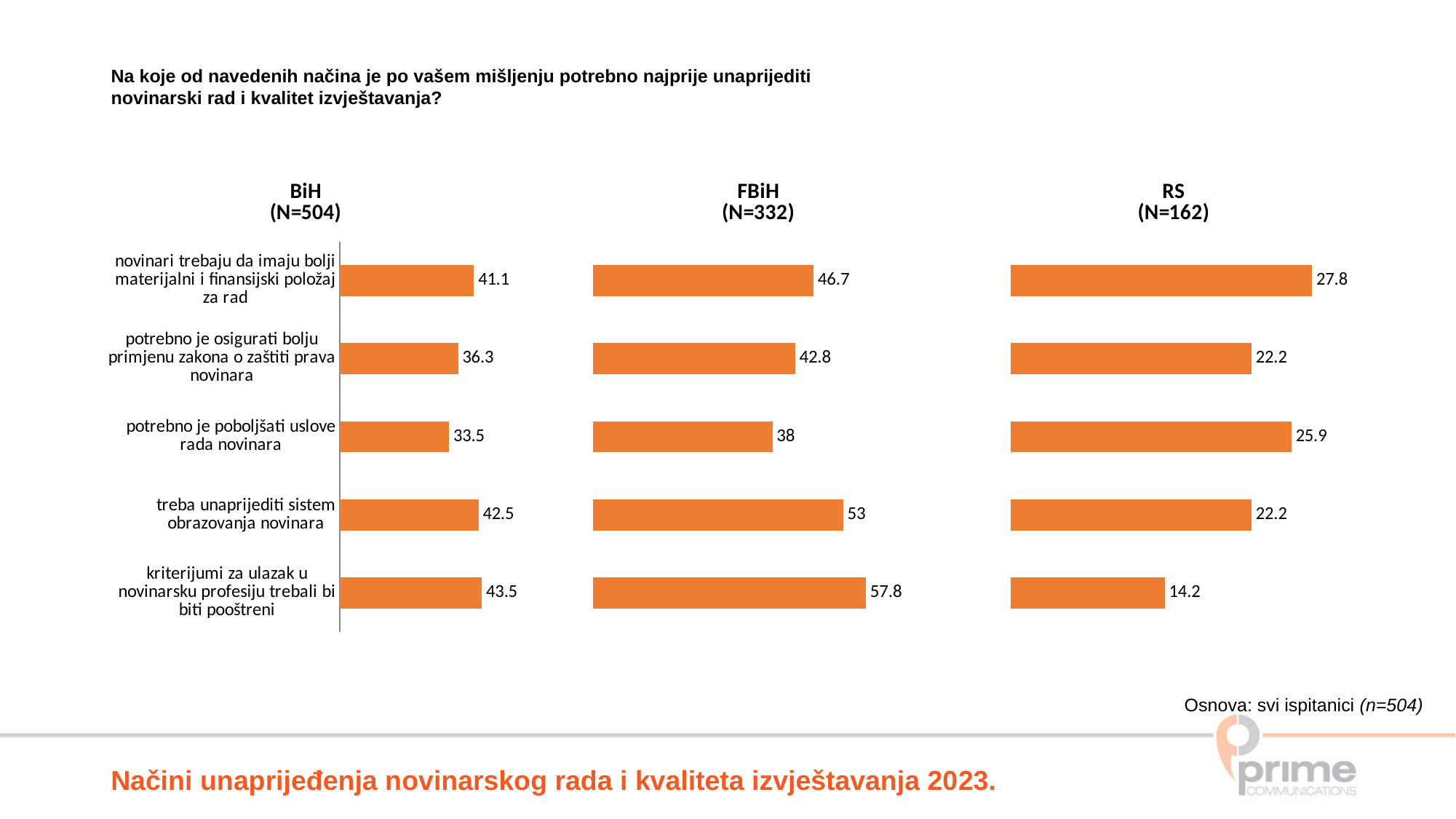
In the FBiH (N=332) chart, what is the difference between the values for "kriterijumi za ulazak u novinarsku profesiju trebali bi biti pooštreni" and "novinari trebaju da imaju bolji materijalni i finansijski položaj za rad"? 11.1 In the FBiH (N=332) chart, which category has the highest value? kriterijumi za ulazak u novinarsku profesiju trebali bi biti pooštreni In the RS (N=162) chart, what is the value for "kriterijumi za ulazak u novinarsku profesiju trebali bi biti pooštreni"? 14.2 What kind of chart is the RS (N=162) chart? bar chart Which is larger: the value for "treba unaprijediti sistem obrazovanja novinara" in the FBiH (N=332) chart or in the RS (N=162) chart? FBiH (N=332) In the BiH (N=504) chart, what is the difference between the values for "novinari trebaju da imaju bolji materijalni i finansijski položaj za rad" and "potrebno je osigurati bolju primjenu zakona o zaštiti prava novinara"? 4.8 In the FBiH (N=332) chart, what is the value for "potrebno je poboljšati uslove rada novinara"? 38 In the BiH (N=504) chart, what is the value for "treba unaprijediti sistem obrazovanja novinara"? 42.5 In the RS (N=162) chart, which category has the highest value? novinari trebaju da imaju bolji materijalni i finansijski položaj za rad In the BiH (N=504) chart, which category has the lowest value? potrebno je poboljšati uslove rada novinara In the RS (N=162) chart, which category has the lowest value? kriterijumi za ulazak u novinarsku profesiju trebali bi biti pooštreni How many categories are shown in the BiH (N=504) chart? 5